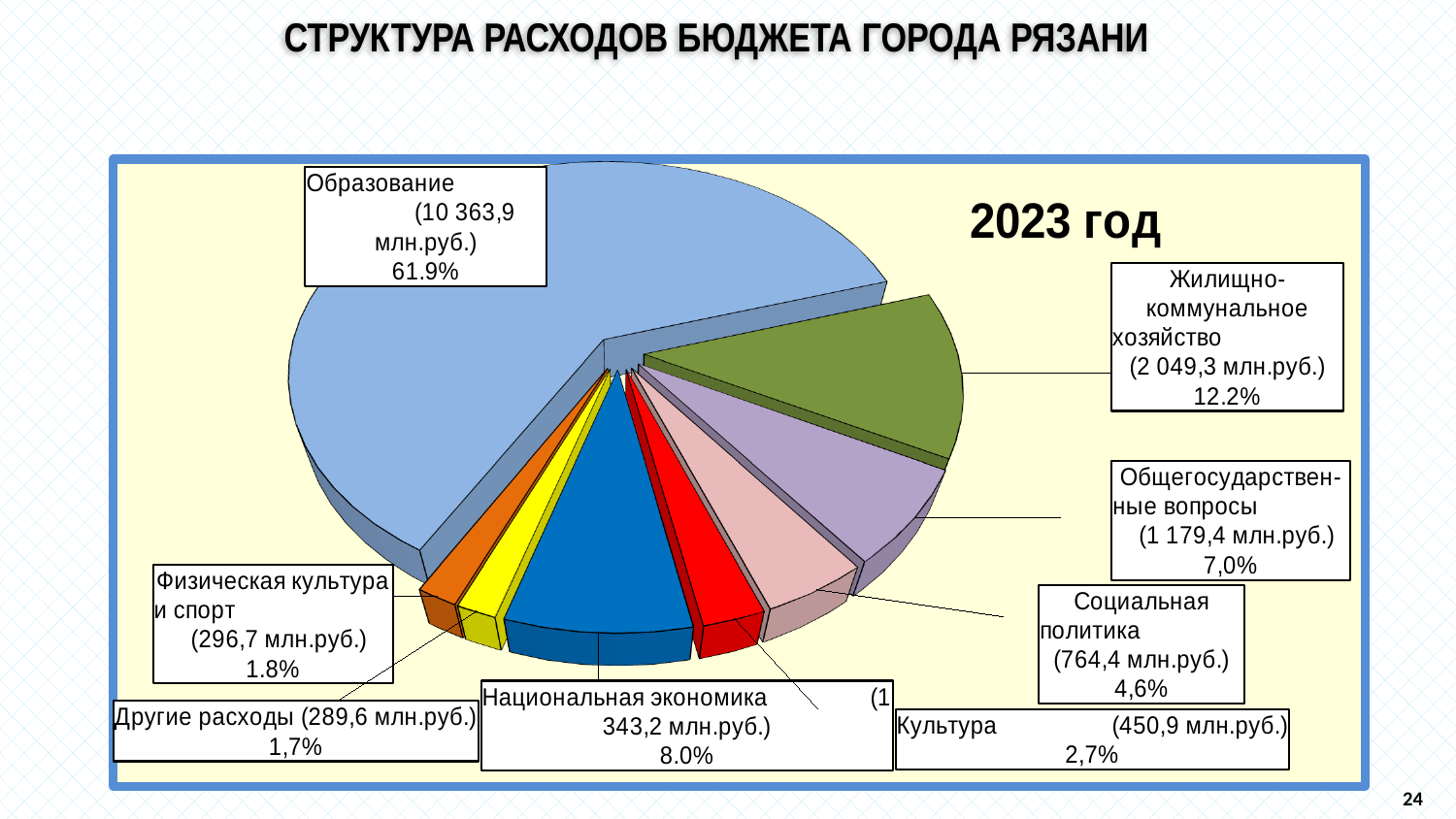
What type of chart is shown on the slide? pie chart What is the value for Жилищно-коммунальное хозяйство in млн.руб.? 2 049,3 млн.руб. What percentage share does Общегосударственные вопросы have? 7,0% What is the value for Социальная политика? 764,4 млн.руб. What share of the pie does Культура represent? 2,7% What is the value for Физическая культура и спорт? 296,7 млн.руб. How many categories are shown in the pie chart? 8 Which year does the chart refer to? 2023 год Which category has the largest share of the pie? Образование Which category has the smallest share of the pie? Другие расходы What share of the budget expenditure does Образование account for? 61.9%